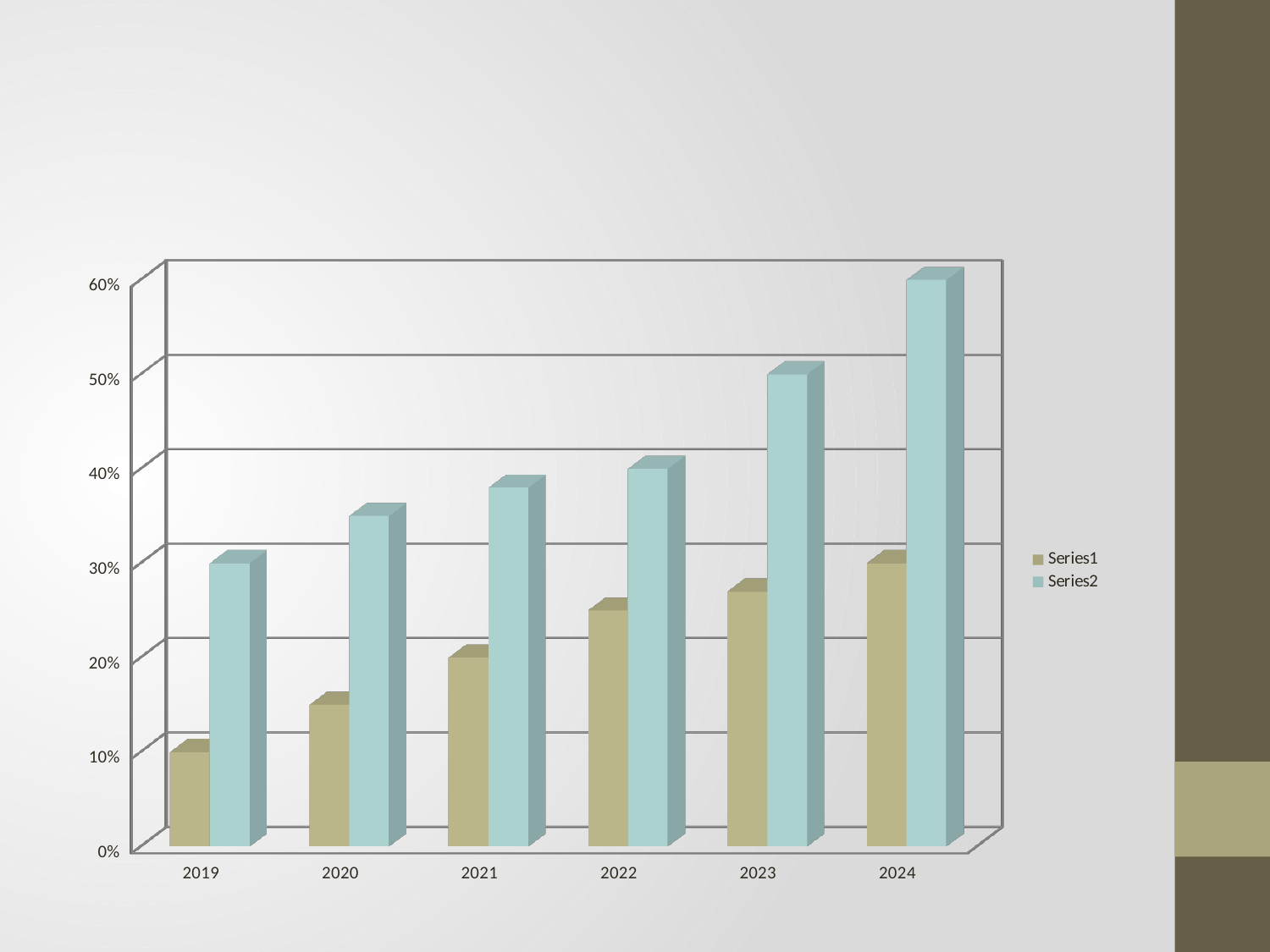
Which year has the lowest Series1 value? 2019 Which year has the highest Series2 value? 2024 Is the Series2 value for 2020 greater or less than 30%? greater Which is larger in 2021, Series1 or Series2? Series2 Is the Series2 value for 2023 greater or less than 40%? greater How many years are shown on the x axis? 6 How many series does the legend list? 2 What kind of chart is shown on the slide? bar chart Is the Series1 value for 2020 greater or less than 20%? less Do the Series2 values rise or fall from 2019 to 2024? rise What are the two legend entries? Series1 and Series2